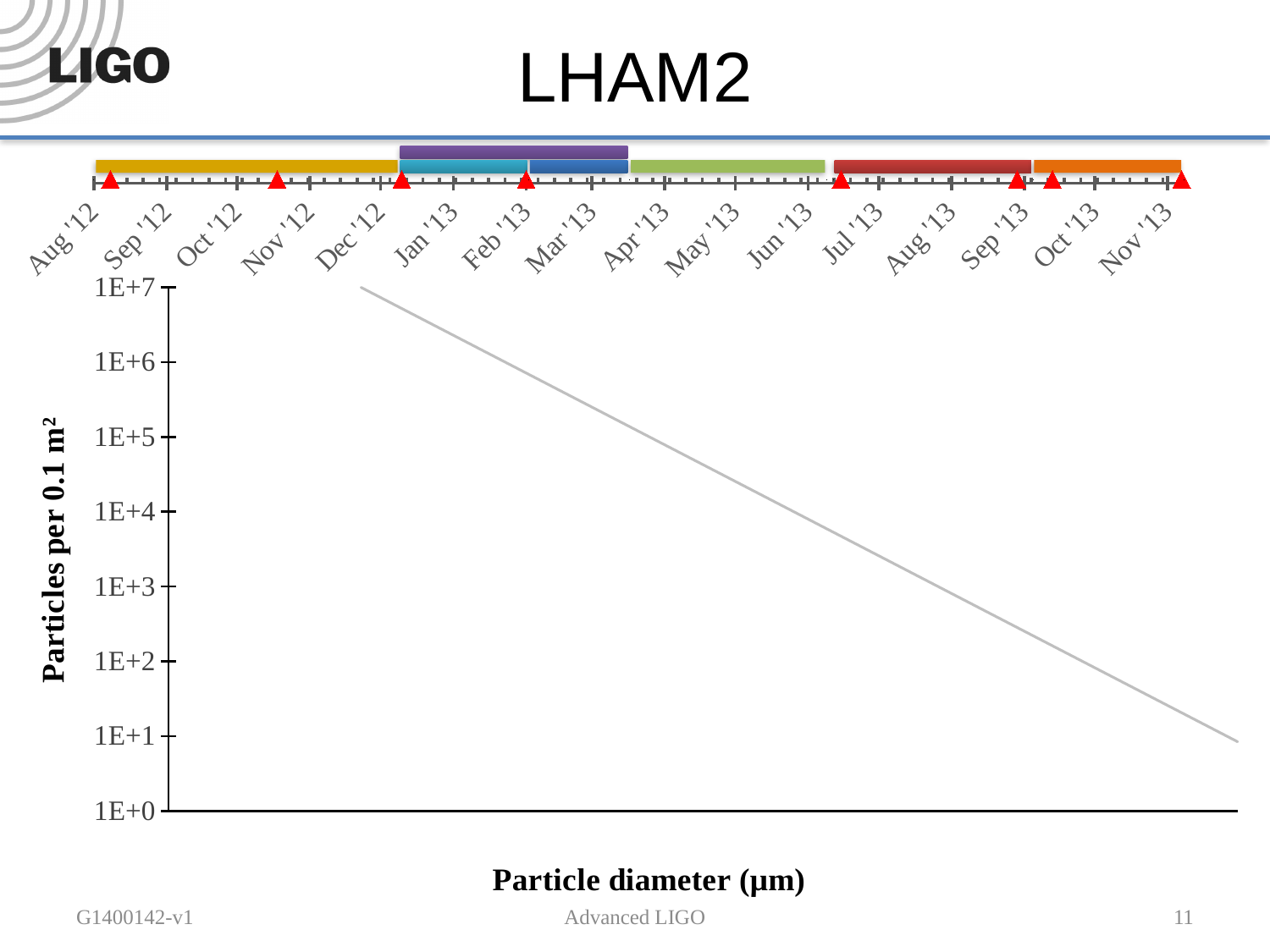
What is the lowest tick value shown on the y-axis? 1E+0 Is the value at the right end of the plotted line greater or less than 1E+2? less What is the label of the x-axis of the chart? Particle diameter (µm) What type of chart is shown on the slide? line chart Is the value at the left end of the plotted line greater or less than 1E+6? greater What is the highest tick value shown on the y-axis? 1E+7 How many month labels are shown on the timeline above the chart? 16 How many lines are plotted on the chart? 1 What is the label of the y-axis of the chart? Particles per 0.1 m² Does the plotted line rise or fall as particle diameter increases along the x axis? fall What is the title of the slide containing the chart? LHAM2 What is the first month label on the timeline above the chart? Aug '12